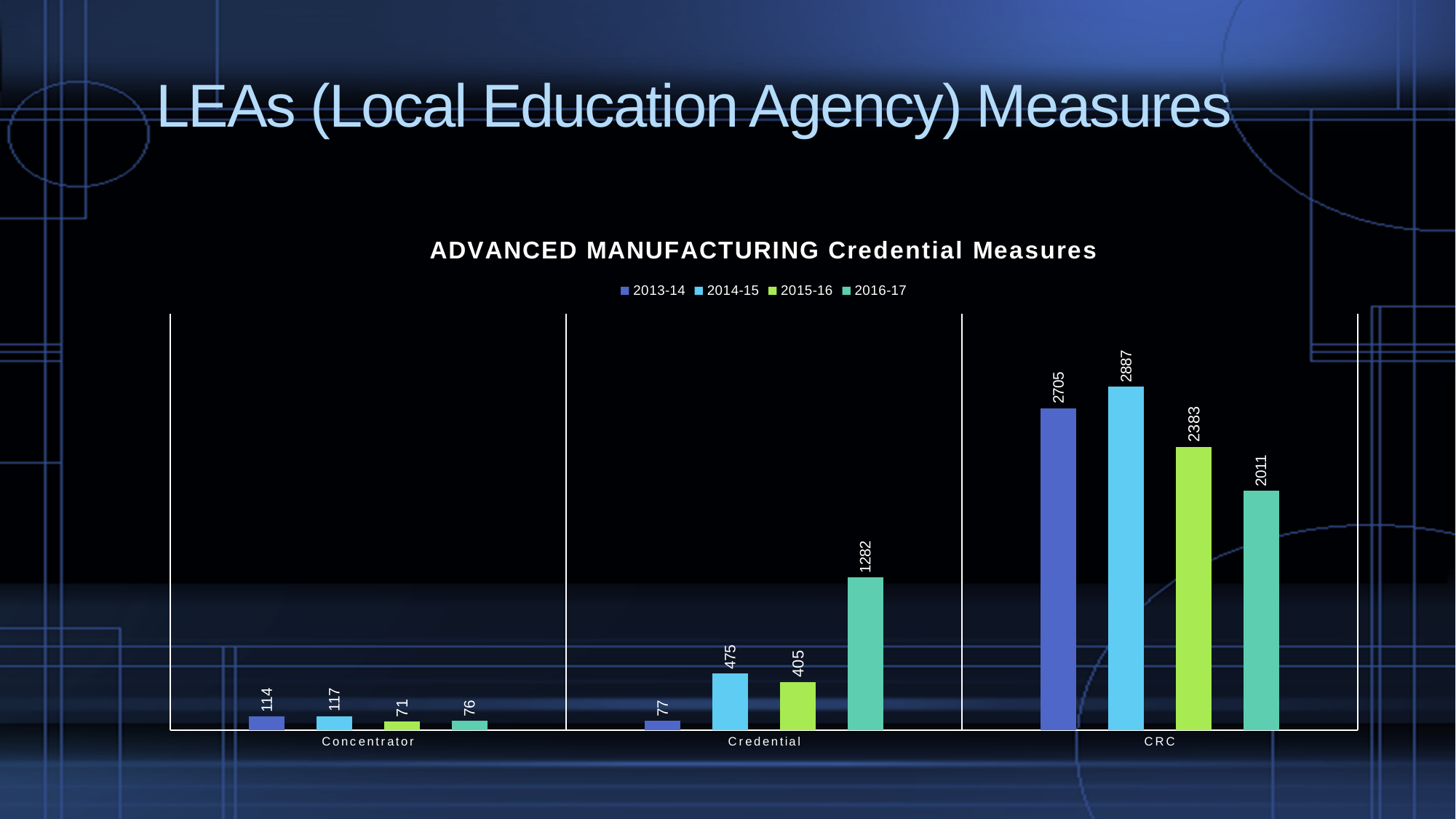
Which year has the lowest value in the Credential category? 2013-14 What is the value for 2015-16 in the Concentrator category? 71 What is the value for 2016-17 in the Credential category? 1282 What is the title of the chart? ADVANCED MANUFACTURING Credential Measures Do the values in the CRC category rise or fall from 2014-15 to 2016-17? Fall How many categories are shown on the x axis? 3 How many series does the legend list? 4 Which year has the highest value in the CRC category? 2014-15 What kind of chart is shown on the slide? Bar chart What is the difference between the 2014-15 and 2016-17 values in the CRC category? 876 What is the value for 2013-14 in the CRC category? 2705 Which is larger in the Credential category: the 2014-15 value or the 2015-16 value? 2014-15